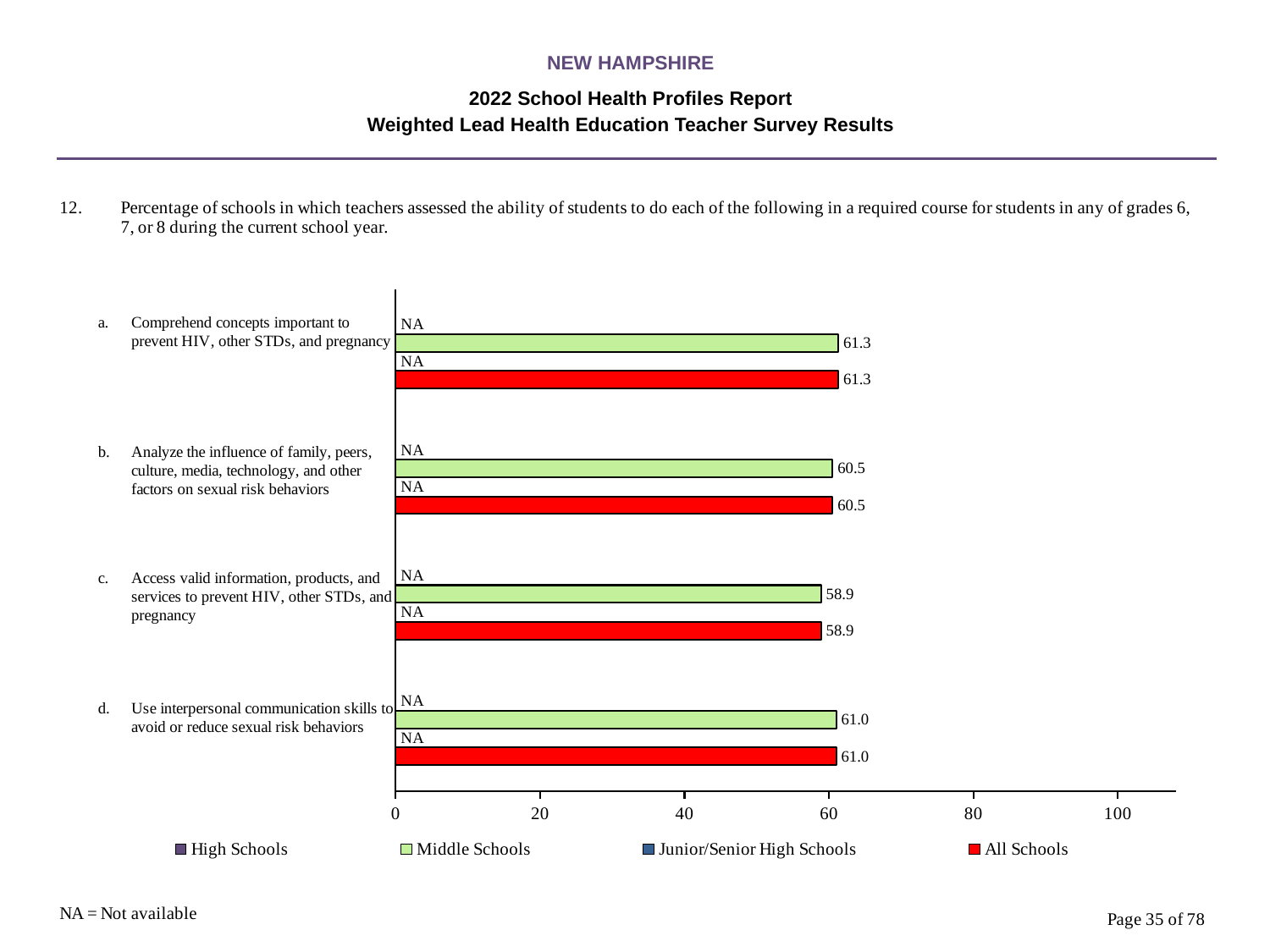
What is shown for High Schools for item a? NA What kind of chart is shown? bar chart What is the All Schools value for item d, use interpersonal communication skills to avoid or reduce sexual risk behaviors? 61.0 Which item has the lowest All Schools value? c. Access valid information, products, and services to prevent HIV, other STDs, and pregnancy What is the difference between the Middle Schools values for item a and item c? 2.4 Which item has the highest Middle Schools value? a. Comprehend concepts important to prevent HIV, other STDs, and pregnancy What is the Middle Schools value for item a, comprehend concepts important to prevent HIV, other STDs, and pregnancy? 61.3 Is the All Schools value for item b greater or less than 60? greater How many series does the legend list? 4 What is the All Schools value for item b, analyze the influence of family, peers, culture, media, technology, and other factors on sexual risk behaviors? 60.5 How many items (categories) are plotted on the chart? 4 What is the Middle Schools value for item c, access valid information, products, and services to prevent HIV, other STDs, and pregnancy? 58.9